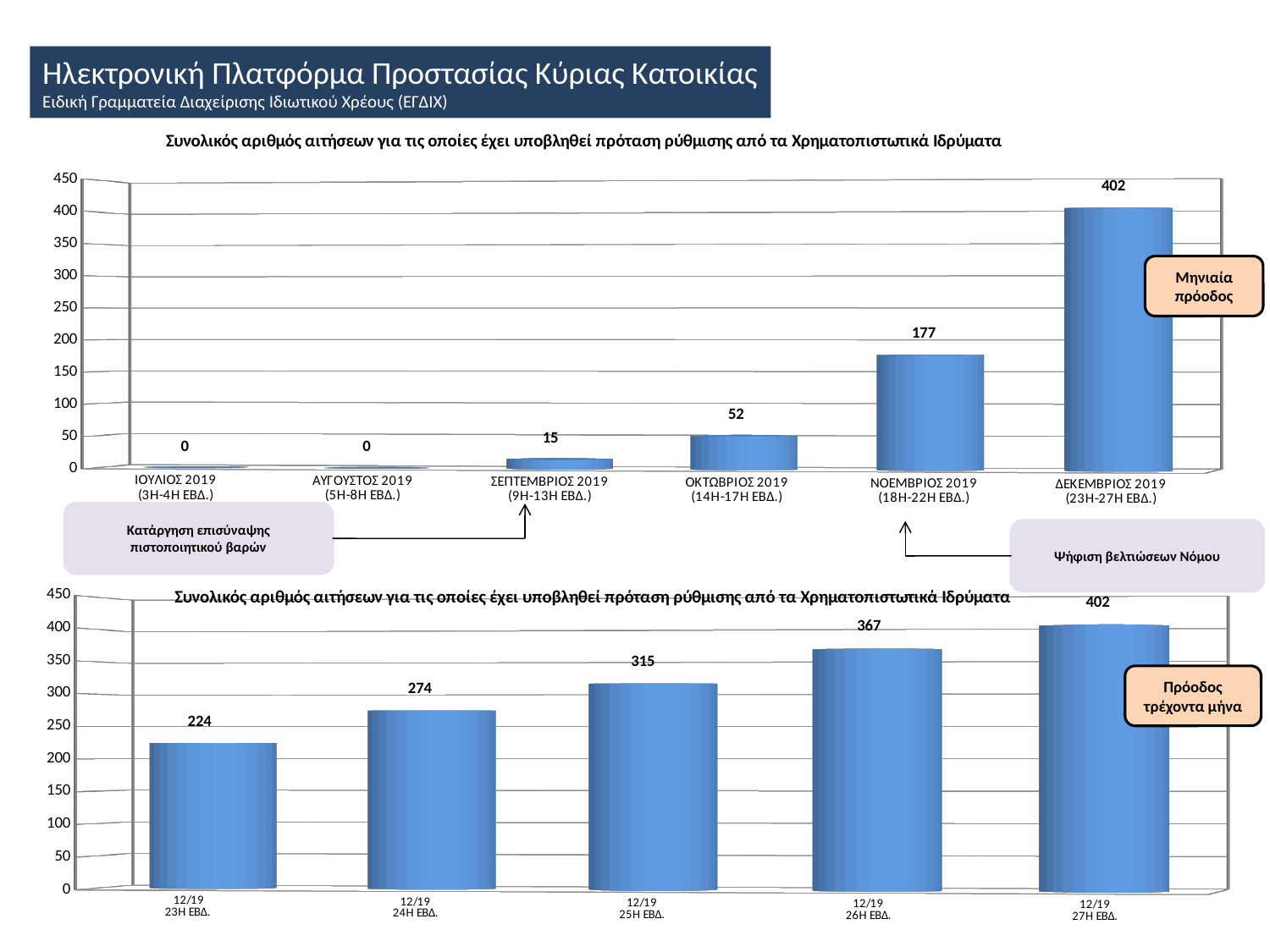
In the top chart, do the values rise or fall from ΣΕΠΤΕΜΒΡΙΟΣ 2019 to ΔΕΚΕΜΒΡΙΟΣ 2019? rise In the top chart, which month has the highest value? ΔΕΚΕΜΒΡΙΟΣ 2019 In the top chart, what is the value for ΟΚΤΩΒΡΙΟΣ 2019? 52 In the top chart, what is the value for ΔΕΚΕΜΒΡΙΟΣ 2019? 402 In the bottom chart, how many bars are plotted? 5 In the bottom chart, what is the value for 12/19 26Η ΕΒΔ.? 367 In the top chart, what is the difference between the values for ΝΟΕΜΒΡΙΟΣ 2019 and ΟΚΤΩΒΡΙΟΣ 2019? 125 What type of chart is the bottom chart? bar chart In the top chart, how many months are shown on the x axis? 6 In the bottom chart, which week has the lowest value? 12/19 23Η ΕΒΔ. In the bottom chart, what is the difference between the values for 12/19 27Η ΕΒΔ. and 12/19 23Η ΕΒΔ.? 178 In the bottom chart, what is the value for 12/19 24Η ΕΒΔ.? 274